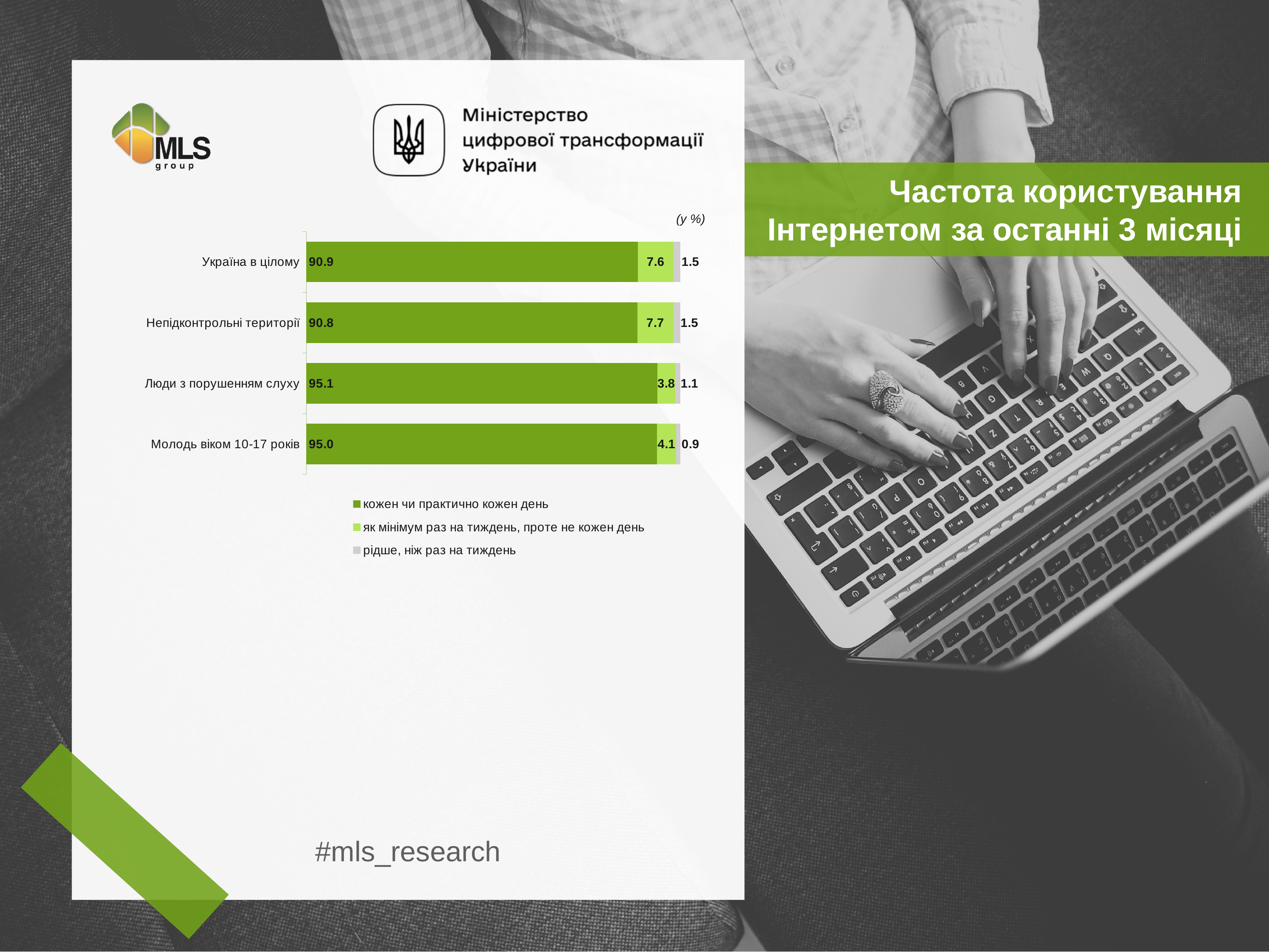
What is the difference between the 'кожен чи практично кожен день' values for 'Люди з порушенням слуху' and 'Україна в цілому'? 4.2 What is the value for 'кожен чи практично кожен день' for 'Люди з порушенням слуху'? 95.1 What is the value for 'як мінімум раз на тиждень, проте не кожен день' for 'Непідконтрольні території'? 7.7 What is the value for 'кожен чи практично кожен день' for 'Україна в цілому'? 90.9 What is the value for 'рідше, ніж раз на тиждень' for 'Молодь віком 10-17 років'? 0.9 Which category has the highest value for 'кожен чи практично кожен день'? Люди з порушенням слуху How many series does the legend list? 3 How many categories are shown in the chart? 4 What is the total of the stacked bar for 'Непідконтрольні території'? 100.0 Which is larger: the 'як мінімум раз на тиждень, проте не кожен день' value for 'Україна в цілому' or for 'Молодь віком 10-17 років'? Україна в цілому Which category has the lowest value for 'рідше, ніж раз на тиждень'? Молодь віком 10-17 років What kind of chart is shown on the slide? Stacked bar chart